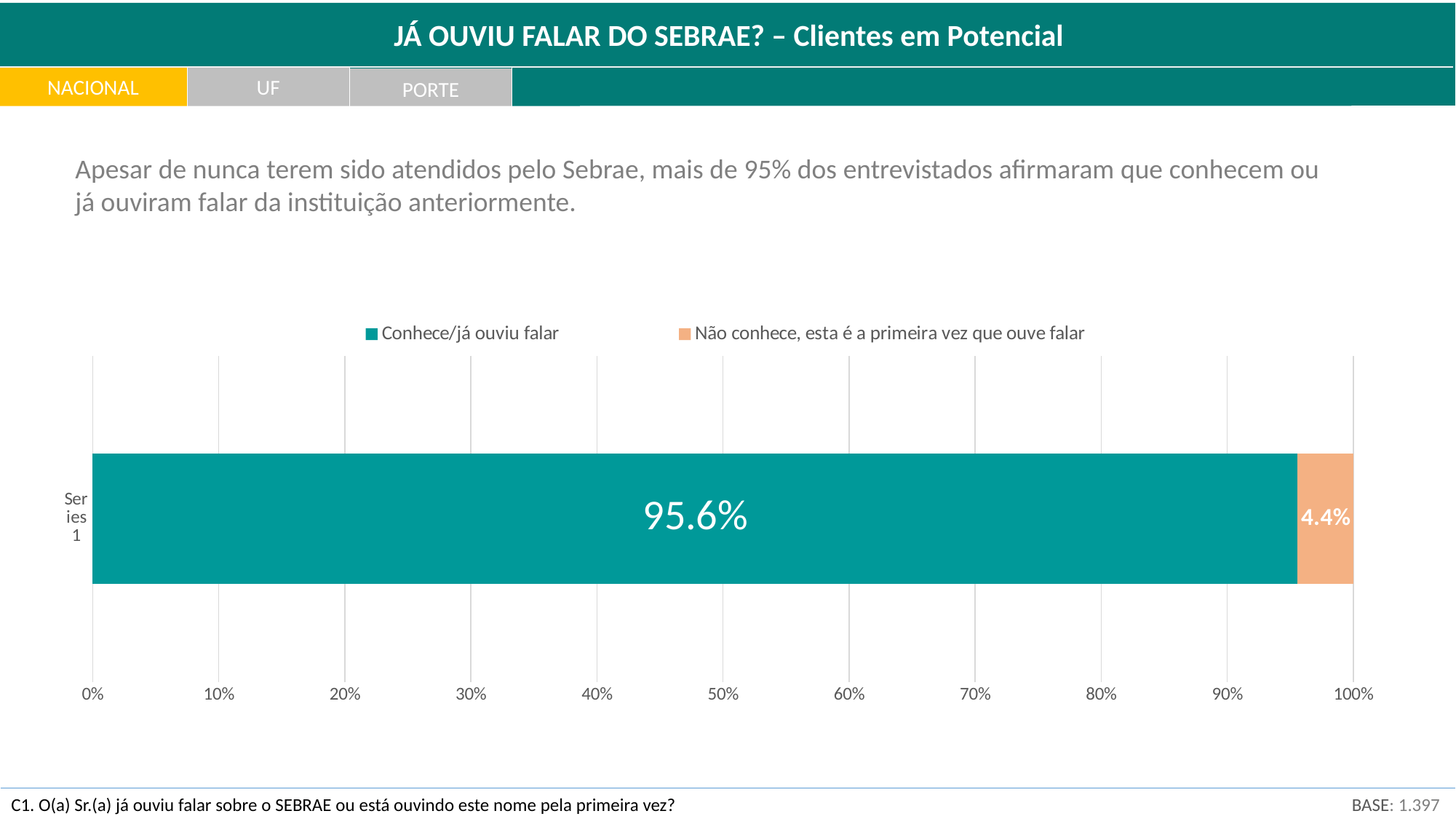
What is the value for "Não conhece, esta é a primeira vez que ouve falar"? 4.4% What colour is the bar segment for "Conhece/já ouviu falar"? Teal What is the total of the stacked bar? 100% How many series does the legend list? 2 What kind of chart is shown on the slide? Bar chart What is the value for "Conhece/já ouviu falar"? 95.6% Which series has the larger value, "Conhece/já ouviu falar" or "Não conhece, esta é a primeira vez que ouve falar"? Conhece/já ouviu falar Is the value for "Não conhece, esta é a primeira vez que ouve falar" greater or less than 10%? less Which series has the lowest value? Não conhece, esta é a primeira vez que ouve falar What is the highest value shown on the x axis? 100% What is the difference between the "Conhece/já ouviu falar" value and the "Não conhece, esta é a primeira vez que ouve falar" value? 91.2% Is the value for "Conhece/já ouviu falar" greater or less than 90%? greater